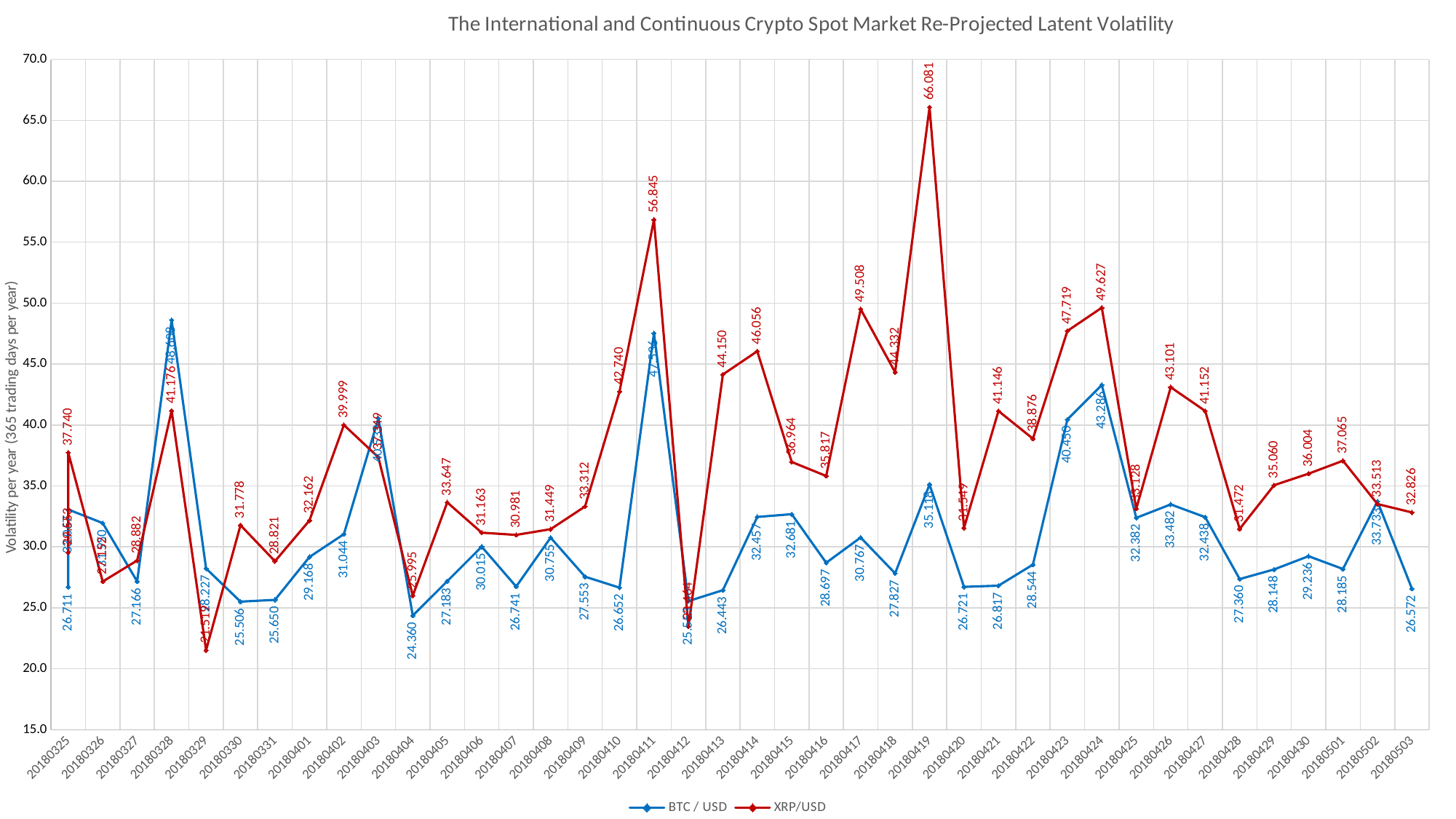
What is the y-axis label of the chart? Volatility per year (365 trading days per year) Which is larger on 20180414: the XRP/USD value or the BTC / USD value? XRP/USD Is the XRP/USD value on 20180329 greater or less than 25.0? less Is the BTC / USD value on 20180328 greater or less than 45.0? greater What is the XRP/USD value on 20180419? 66.081 On which date does XRP/USD reach its highest value? 20180419 How many series does the legend list? 2 How many dates are plotted along the x axis? 40 What is the difference between the XRP/USD and BTC / USD values on 20180411 minus... rather, what is the difference between XRP/USD on 20180419 and XRP/USD on 20180411? 9.236 On which date does BTC / USD reach its lowest value? 20180404 What is the BTC / USD value on 20180404? 24.360 What type of chart is shown on the slide? line chart